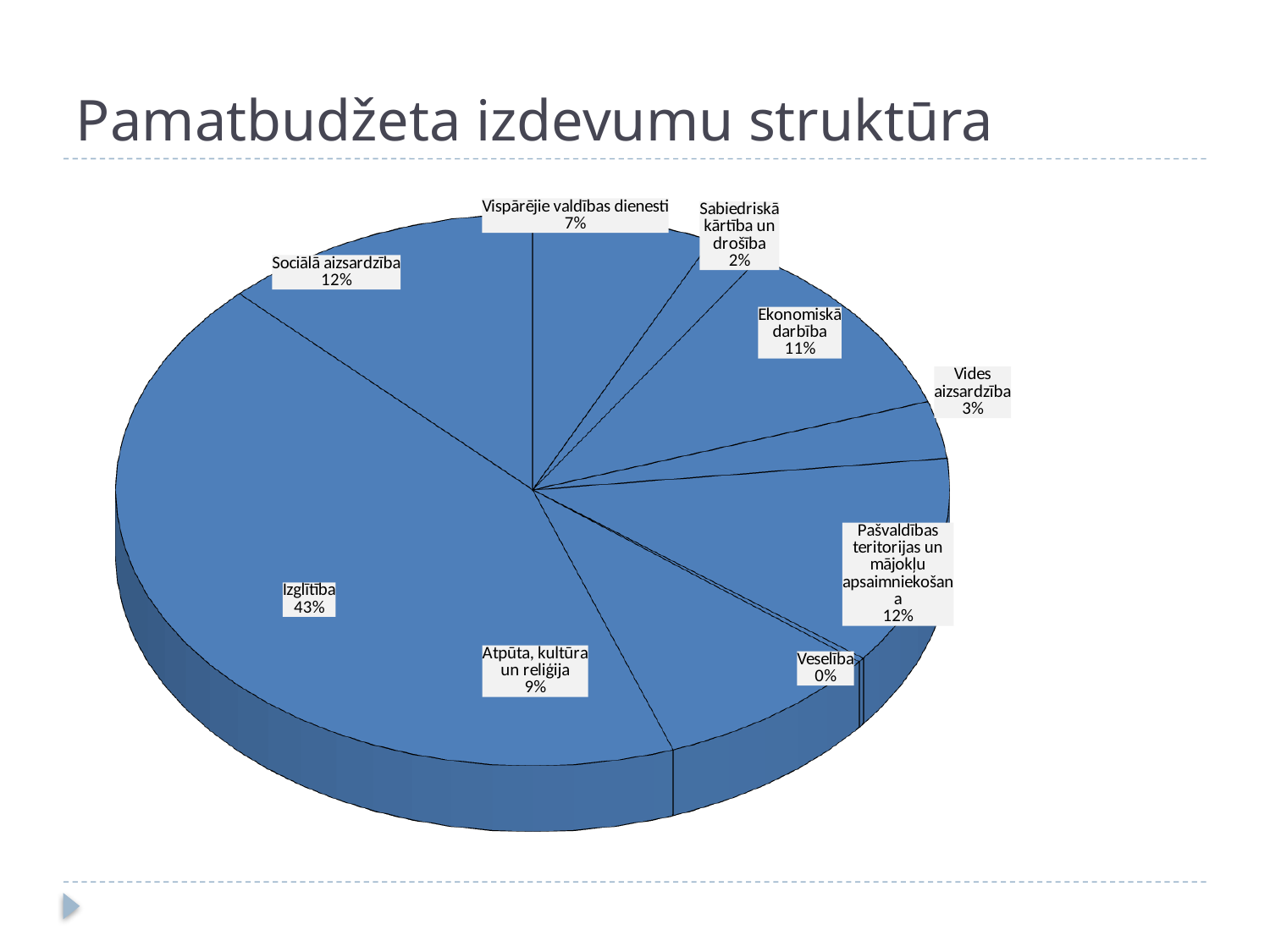
What share of the pie does Izglītība have? 43% What is the title of the chart on the slide? Pamatbudžeta izdevumu struktūra What share of the pie does Vides aizsardzība have? 3% Which category has the largest slice of the pie? Izglītība What share of the pie does Atpūta, kultūra un reliģija have? 9% What kind of chart is shown on the slide? pie chart Which category has the smallest slice of the pie? Veselība Which is larger, the share for Vispārējie valdības dienesti or the share for Sabiedriskā kārtība un drošība? Vispārējie valdības dienesti What is the difference in percentage points between the share for Izglītība and the share for Sociālā aizsardzība? 31 How many slices does the pie chart have? 9